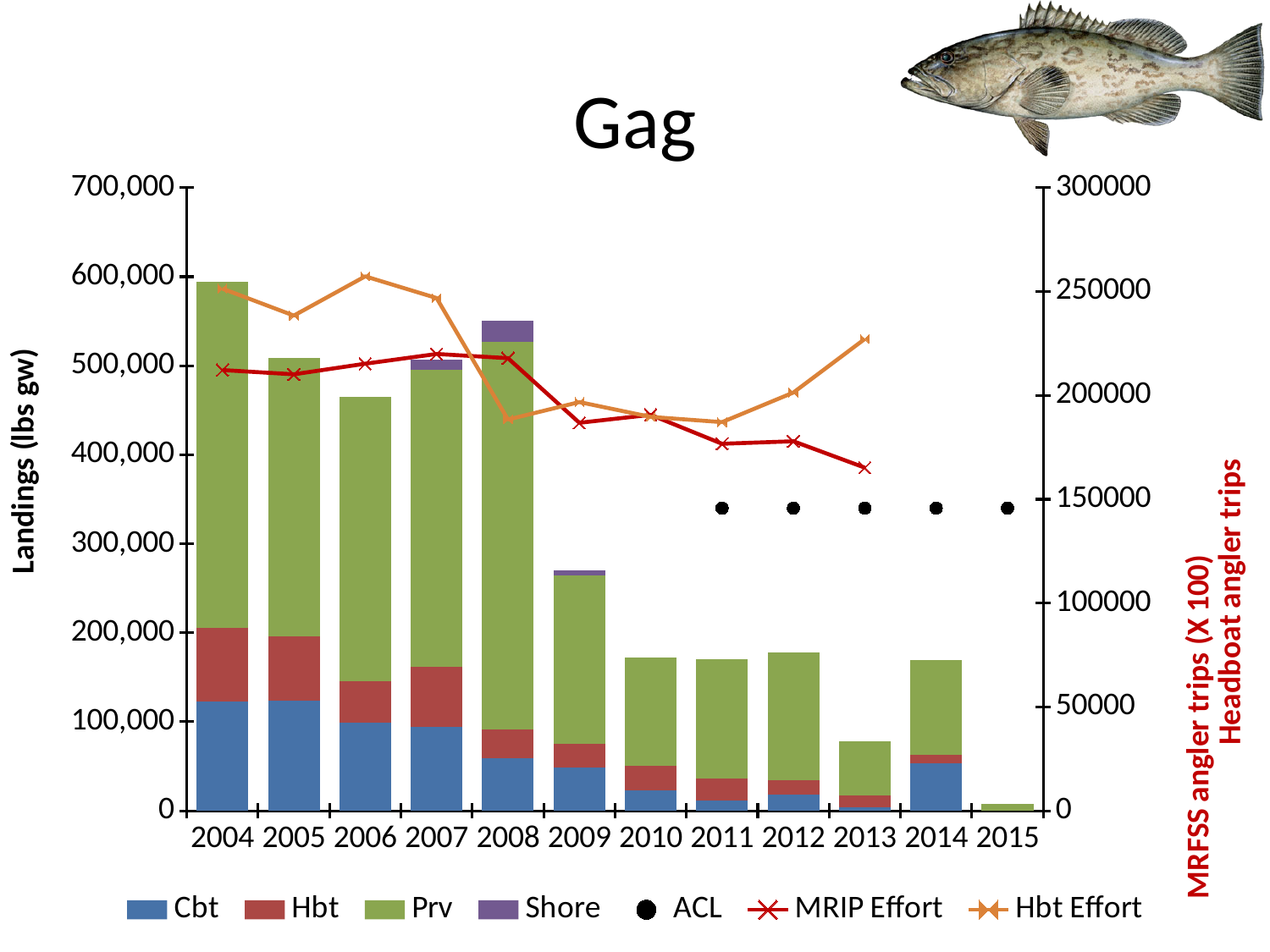
How many years are shown on the x axis? 12 Is the total landings bar for 2004 greater or less than 500,000? greater What kind of chart is used to show the landings? bar chart What is the title of the chart? Gag Which year has the shortest total landings bar? 2015 What is the label of the left vertical axis? Landings (lbs gw) Which year has the larger total landings bar, 2010 or 2013? 2010 Is the total landings bar for 2013 greater or less than 100,000? less Does the MRIP Effort line generally rise or fall from 2004 to 2013? fall How many entries does the legend list? 7 Is the MRIP Effort value for 2013 greater or less than 200000 on the right axis? less Which year has the tallest total landings bar? 2004